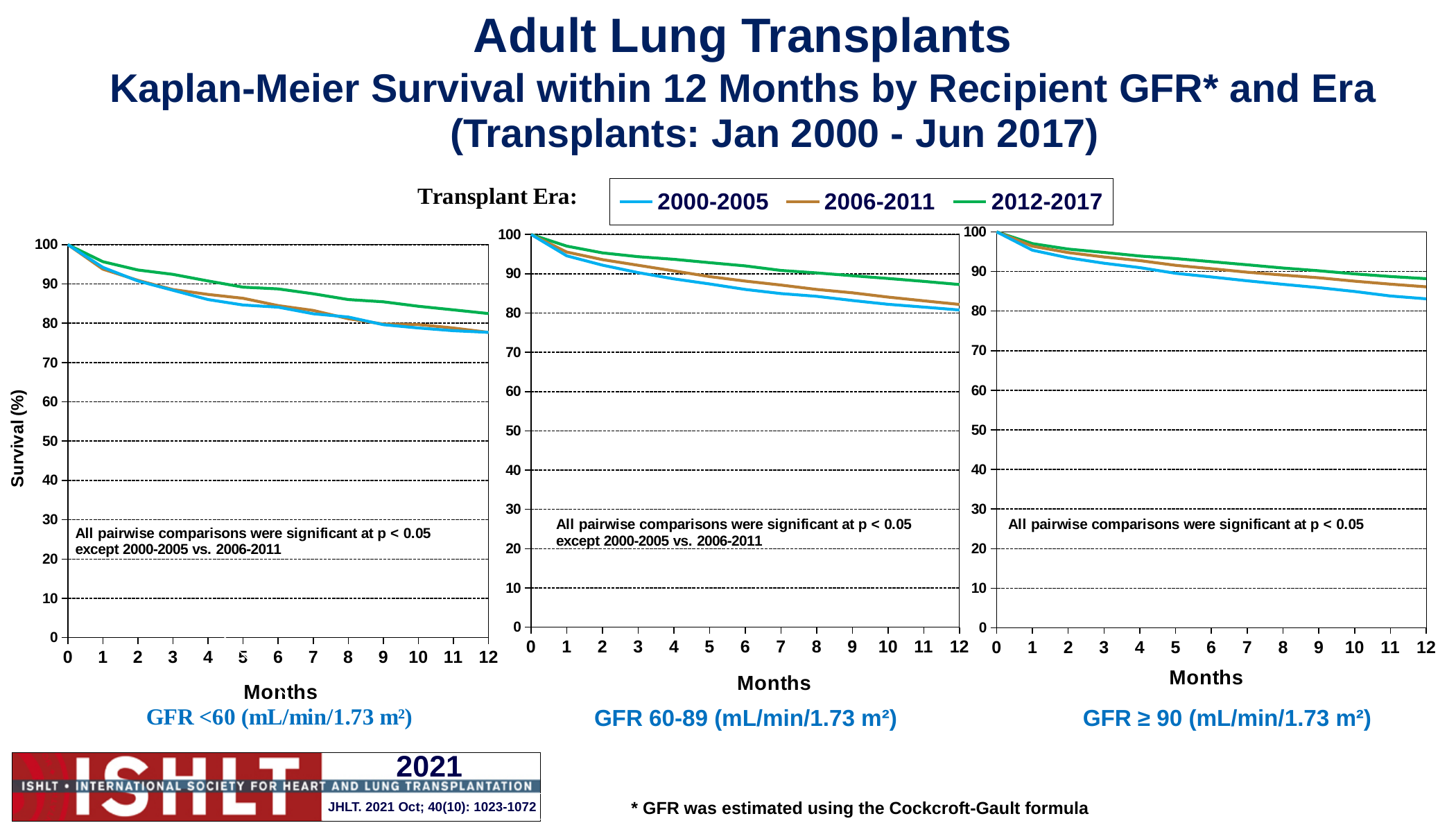
In the GFR 60-89 (mL/min/1.73 m²) chart, is the survival for 2012-2017 at 12 months greater or less than 80? greater In the GFR 60-89 (mL/min/1.73 m²) chart, which era has higher survival at 12 months, 2012-2017 or 2000-2005? 2012-2017 In the GFR ≥ 90 (mL/min/1.73 m²) chart, is the survival for 2000-2005 at 12 months greater or less than 80? greater In the GFR 60-89 (mL/min/1.73 m²) chart, do the survival curves rise or fall as months increase? Fall In the GFR ≥ 90 (mL/min/1.73 m²) chart, which era has the highest survival at 12 months? 2012-2017 What kind of chart is the GFR <60 (mL/min/1.73 m²) chart on the left? Line chart Which transplant eras are listed in the legend? 2000-2005, 2006-2011, 2012-2017 What is the label on the y axis of the GFR <60 (mL/min/1.73 m²) chart? Survival (%) In the GFR <60 (mL/min/1.73 m²) chart, is the survival for 2006-2011 at 6 months greater or less than 80? greater How many transplant eras does the legend list? 3